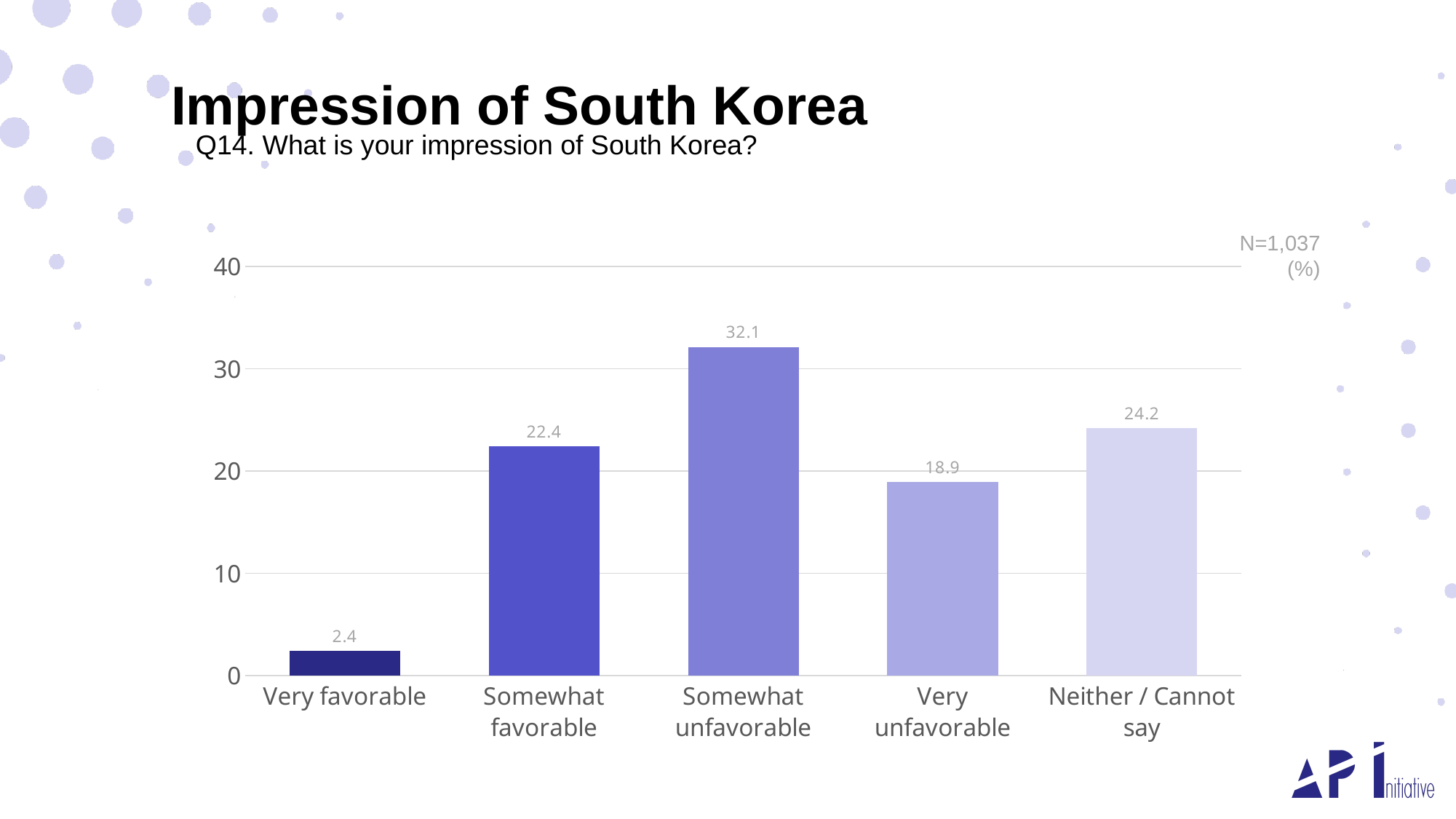
What is the value for Very favorable? 2.4 What is the value for Somewhat unfavorable? 32.1 Which category has the lowest value? Very favorable Which is larger, Somewhat favorable or Very unfavorable? Somewhat favorable What sample size (N) is noted on the chart? N=1,037 What is the value for Neither / Cannot say? 24.2 Is the value for Neither / Cannot say greater or less than 20? greater How many categories are shown on the x axis? 5 What is the difference between Neither / Cannot say and Very unfavorable? 5.3 What is the difference between Somewhat unfavorable and Somewhat favorable? 9.7 What kind of chart is shown on the slide? bar chart Which category has the highest value? Somewhat unfavorable